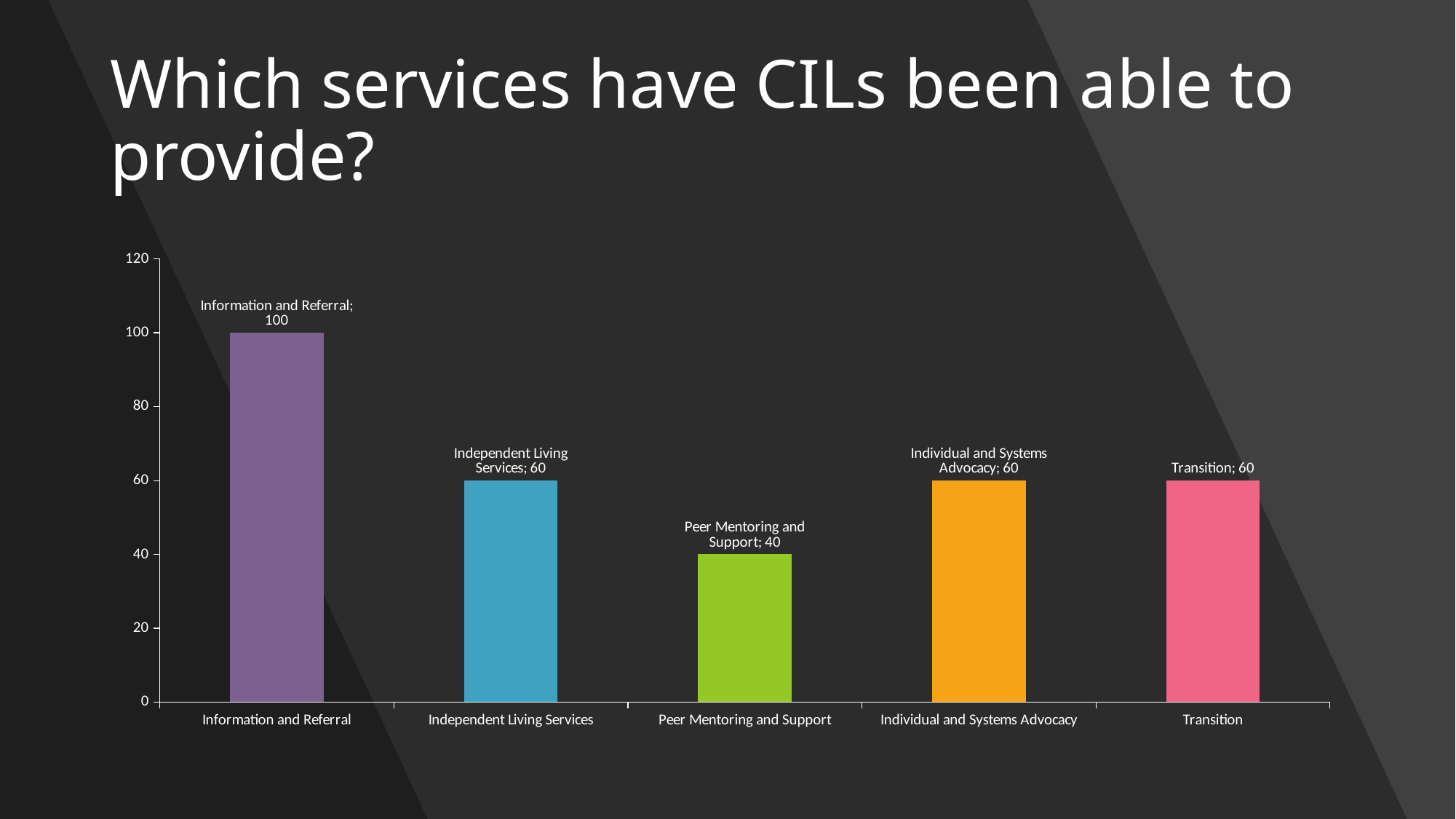
Which category has the highest value? Information and Referral What is the value for Transition? 60 Which category has the lowest value? Peer Mentoring and Support What is the value for Individual and Systems Advocacy? 60 What kind of chart is shown on the slide? bar chart What is the difference between the values for Independent Living Services and Peer Mentoring and Support? 20 Which is larger, the value for Information and Referral or the value for Transition? Information and Referral What is the value for Information and Referral? 100 What is the difference between the values for Information and Referral and Peer Mentoring and Support? 60 Is the value for Information and Referral greater or less than 80? greater What is the value for Peer Mentoring and Support? 40 How many categories are shown on the chart? 5